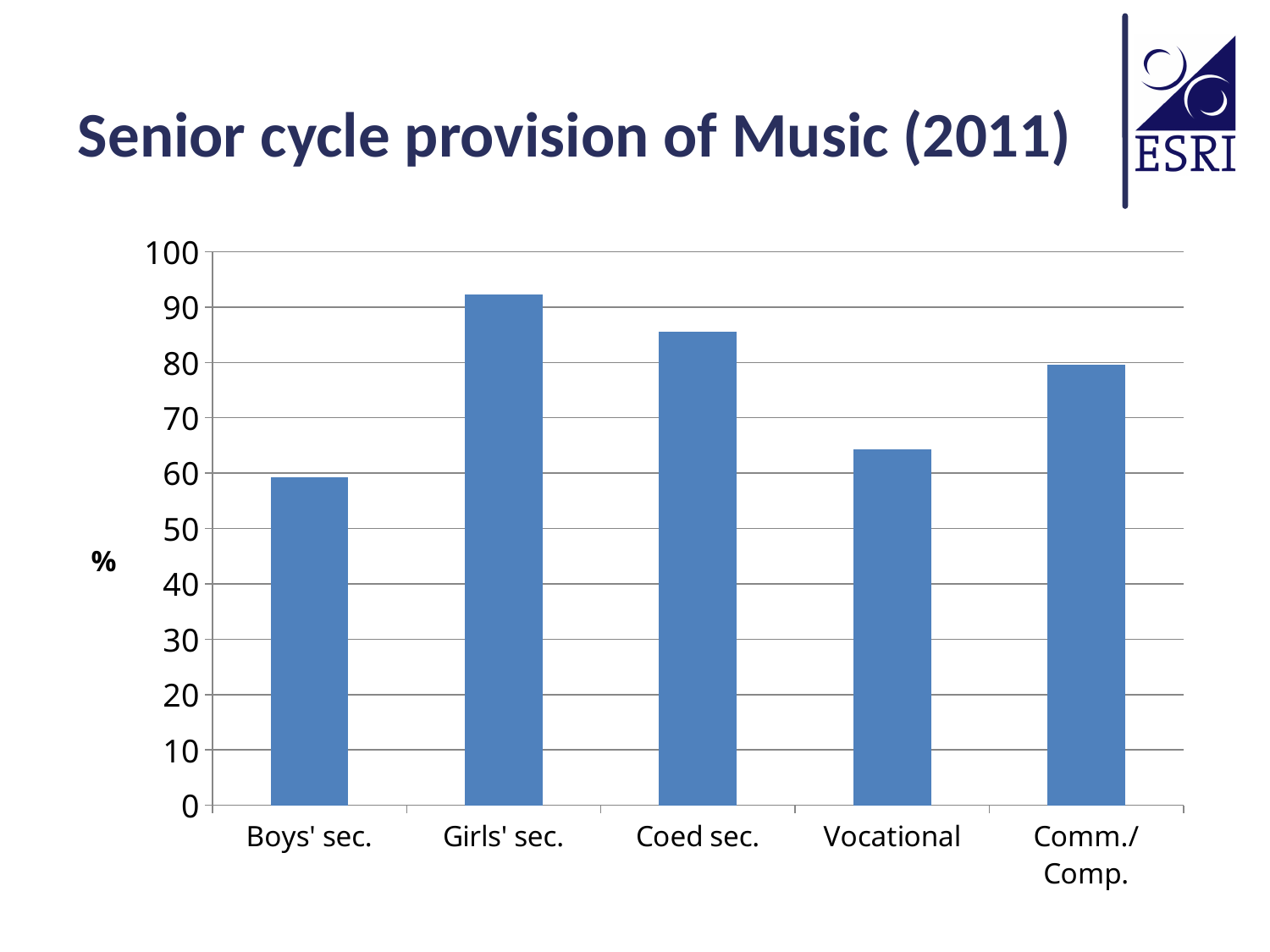
Which is larger, the value for Coed sec. or the value for Vocational? Coed sec. Is the value for Vocational greater or less than 60? greater Is the value for Boys' sec. greater or less than 50? greater What is the title of the chart on the slide? Senior cycle provision of Music (2011) How many school types (categories) are shown on the x axis? 5 Which is larger, the value for Boys' sec. or the value for Vocational? Vocational Is the value for Coed sec. greater or less than 80? greater What type of chart is shown on the slide? Bar chart Which school type has the lowest senior cycle provision of Music? Boys' sec. Which school type has the highest senior cycle provision of Music? Girls' sec.